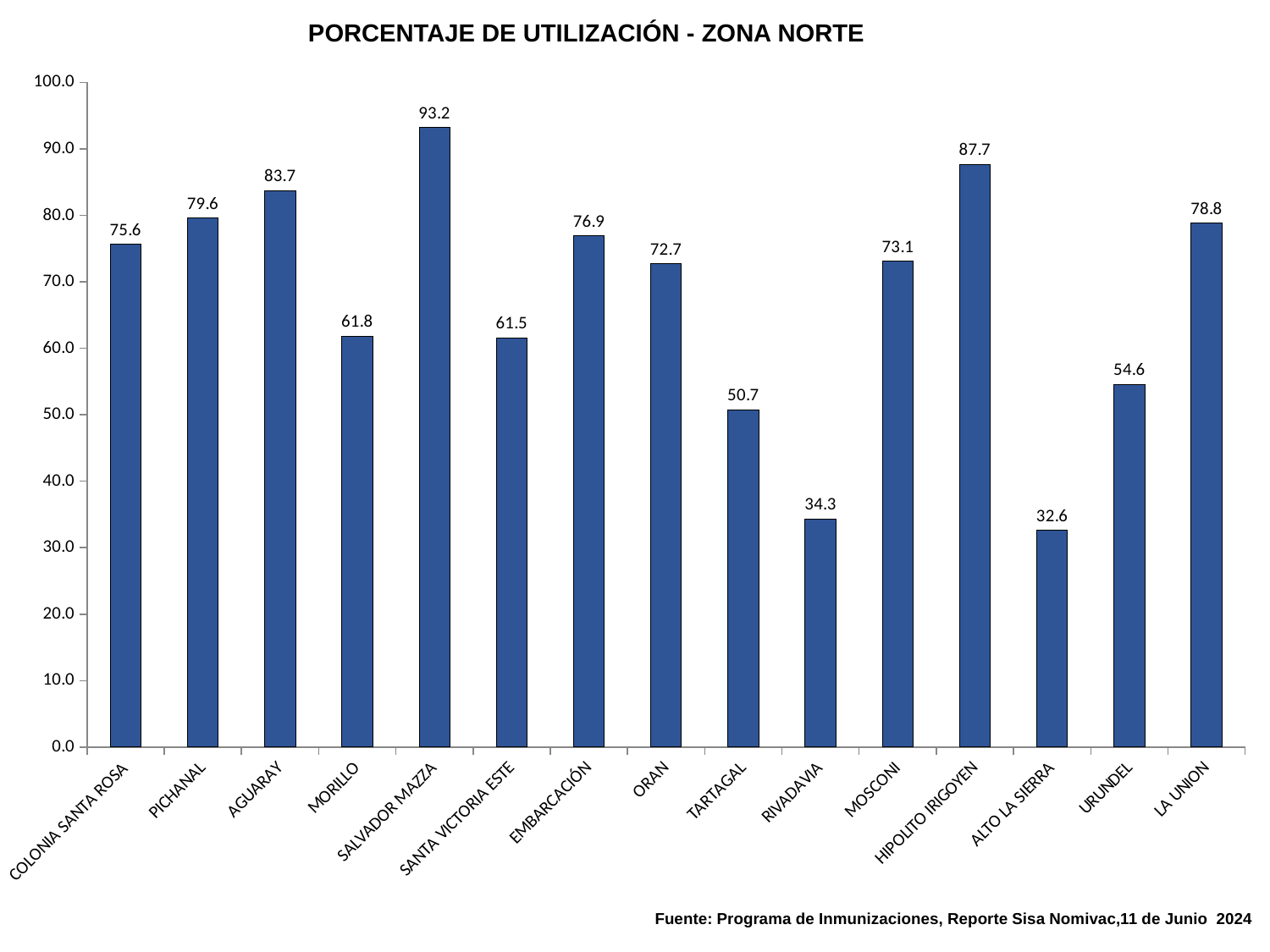
What is the difference between the values for AGUARAY and MORILLO? 21.9 What is the value for URUNDEL? 54.6 Which category has the lowest value? ALTO LA SIERRA What is the difference between the values for HIPOLITO IRIGOYEN and TARTAGAL? 37.0 What is the value for SALVADOR MAZZA? 93.2 What is the value for RIVADAVIA? 34.3 How many categories are shown on the x axis? 15 Which is larger, the value for PICHANAL or the value for LA UNION? PICHANAL Which category has the highest value? SALVADOR MAZZA What is the title of the chart? PORCENTAJE DE UTILIZACIÓN - ZONA NORTE What kind of chart is shown on the slide? Bar chart Is the value for MOSCONI greater or less than 70.0? greater